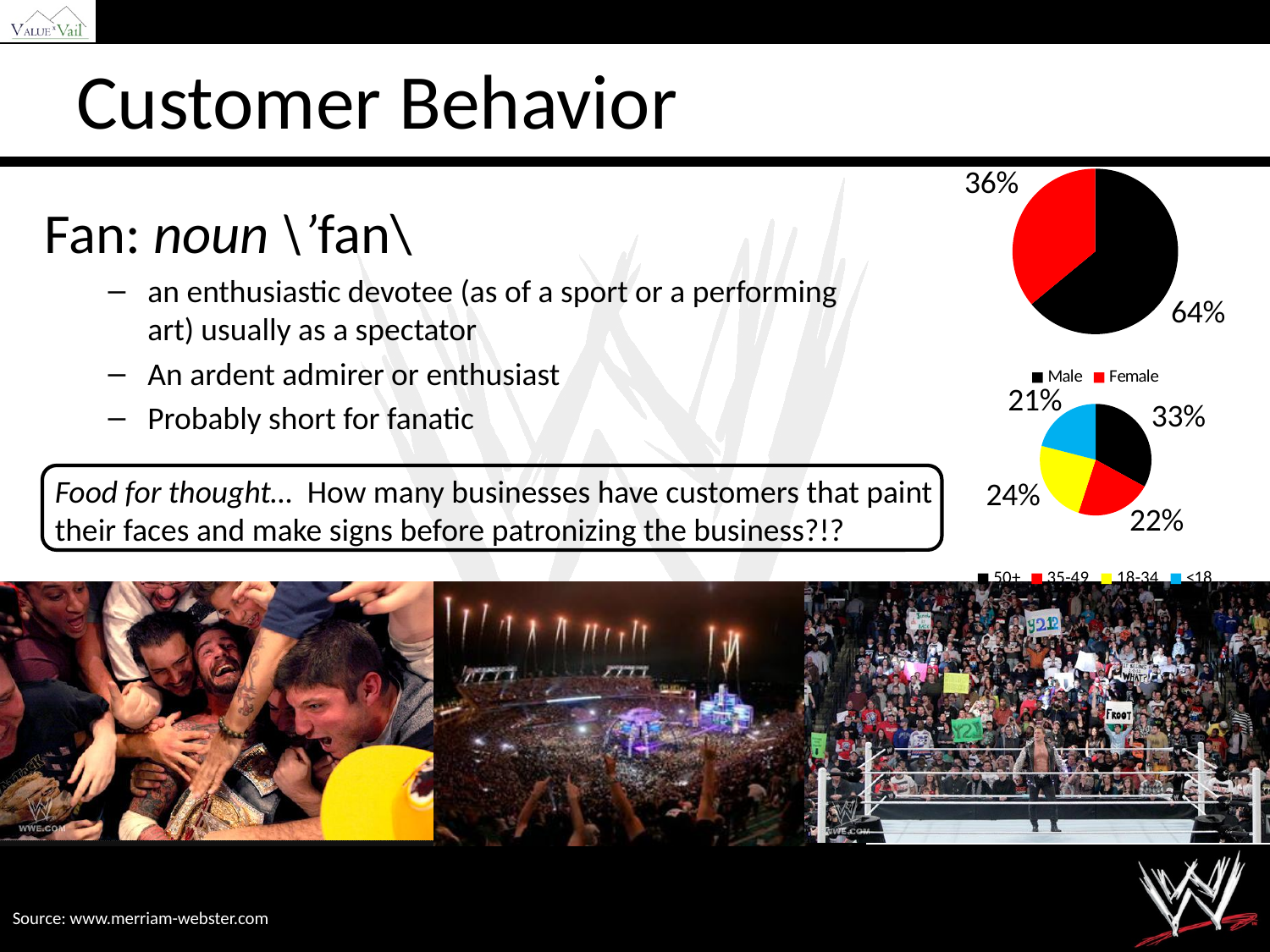
In the top pie chart (gender), what share is Male? 64% In the bottom pie chart (age groups), which age group has the largest share? 50+ In the top pie chart (gender), which category has the larger share? Male In the top pie chart (gender), what is the difference between the Male and Female shares? 28% In the top pie chart (gender), what share is Female? 36% In the bottom pie chart (age groups), which age group has the smallest share? <18 How many entries does the legend of the top pie chart list? 2 In the bottom pie chart (age groups), what share is the 50+ group? 33% In the bottom pie chart (age groups), how many age groups are shown? 4 In the bottom pie chart (age groups), what colour is the 35-49 slice? Red What type of chart is the top chart on the slide? Pie chart In the bottom pie chart (age groups), what share is the 18-34 group? 24%